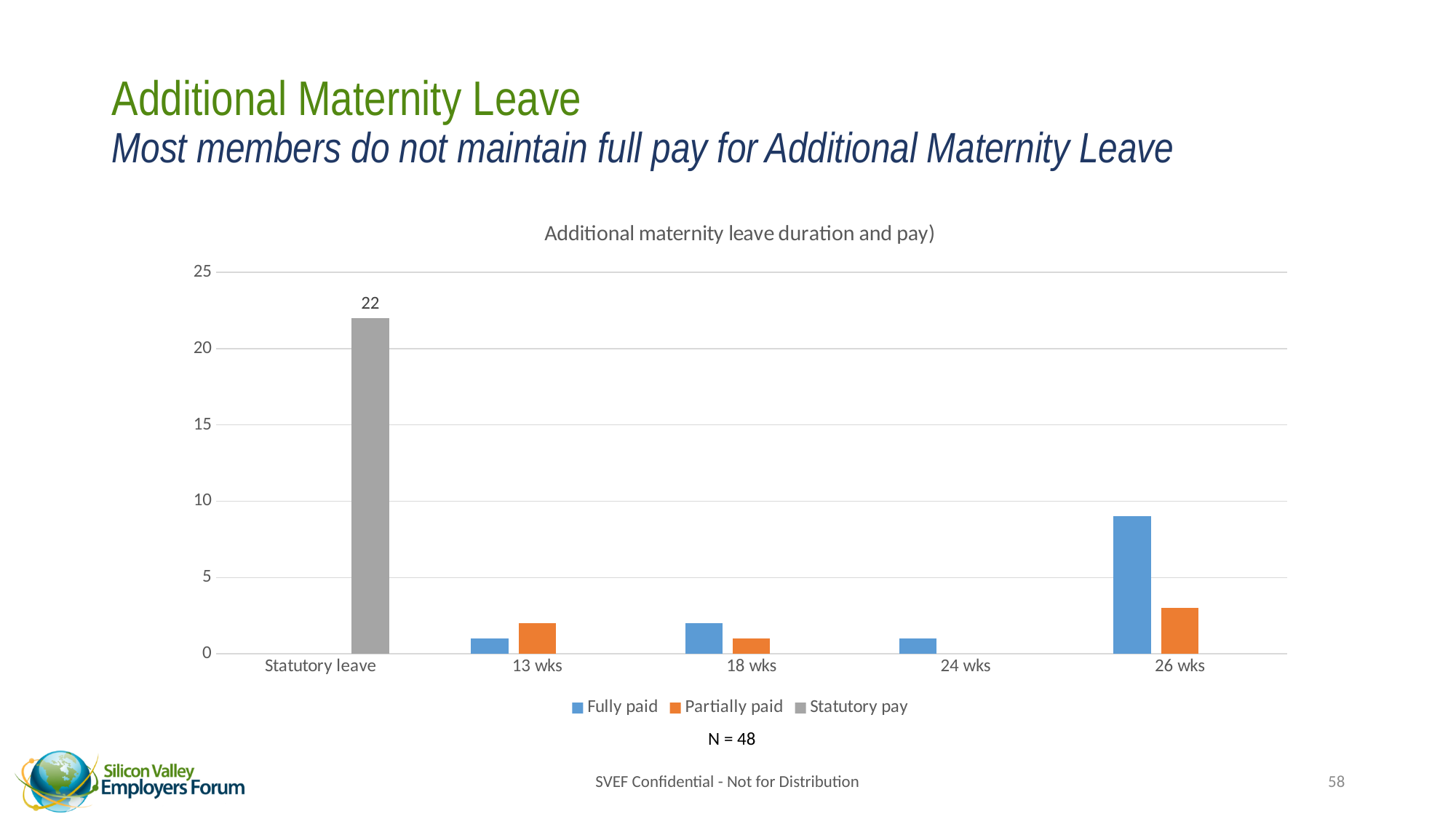
How many series does the chart's legend list? 3 What kind of chart is shown on the slide? bar chart Is the Fully paid value for 26 wks greater or less than 5? greater Is the Partially paid value for 26 wks greater or less than 5? less For 26 wks, which is larger: Fully paid or Partially paid? Fully paid What sample size (N) is stated below the chart? N = 48 What is the value of the Statutory pay bar for Statutory leave? 22 Which series is shown in gray in the chart? Statutory pay For 13 wks, which is larger: Fully paid or Partially paid? Partially paid Which category has the highest Fully paid value? 26 wks How many categories are shown on the x axis of the chart? 5 Is the Statutory pay value for Statutory leave greater or less than 20? greater